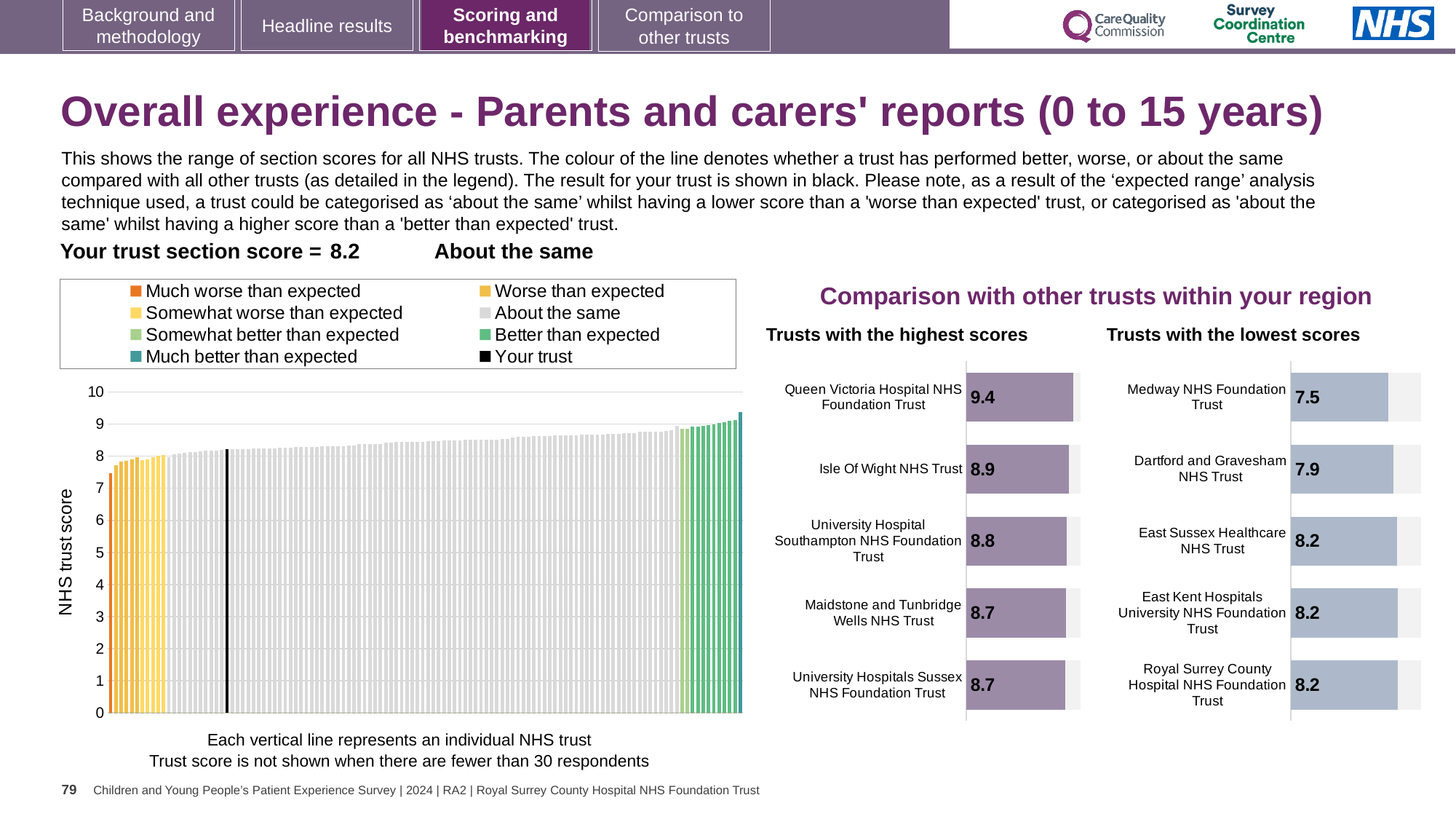
In the 'Trusts with the lowest scores' chart, what is the score for East Sussex Healthcare NHS Trust? 8.2 What kind of chart is the large chart on the left showing NHS trust scores? Bar chart In the 'Trusts with the lowest scores' chart, which trust has the lowest score? Medway NHS Foundation Trust In the 'Trusts with the highest scores' chart, what is the difference between the scores of Queen Victoria Hospital NHS Foundation Trust and Isle Of Wight NHS Trust? 0.5 In the 'Trusts with the highest scores' chart, which trust has the highest score? Queen Victoria Hospital NHS Foundation Trust In the 'Trusts with the highest scores' chart, what is the score for Queen Victoria Hospital NHS Foundation Trust? 9.4 In the 'Trusts with the lowest scores' chart, what is the score for Medway NHS Foundation Trust? 7.5 How many entries does the legend of the large chart on the left list? 8 In the 'Trusts with the highest scores' chart, which has the larger score: Isle Of Wight NHS Trust or University Hospital Southampton NHS Foundation Trust? Isle Of Wight NHS Trust In the large chart on the left, is the value for the black bar (Your trust) greater or less than 5? greater How many trusts are shown in the 'Trusts with the highest scores' chart? 5 In the 'Trusts with the lowest scores' chart, how much higher is the score for Dartford and Gravesham NHS Trust than for Medway NHS Foundation Trust? 0.4